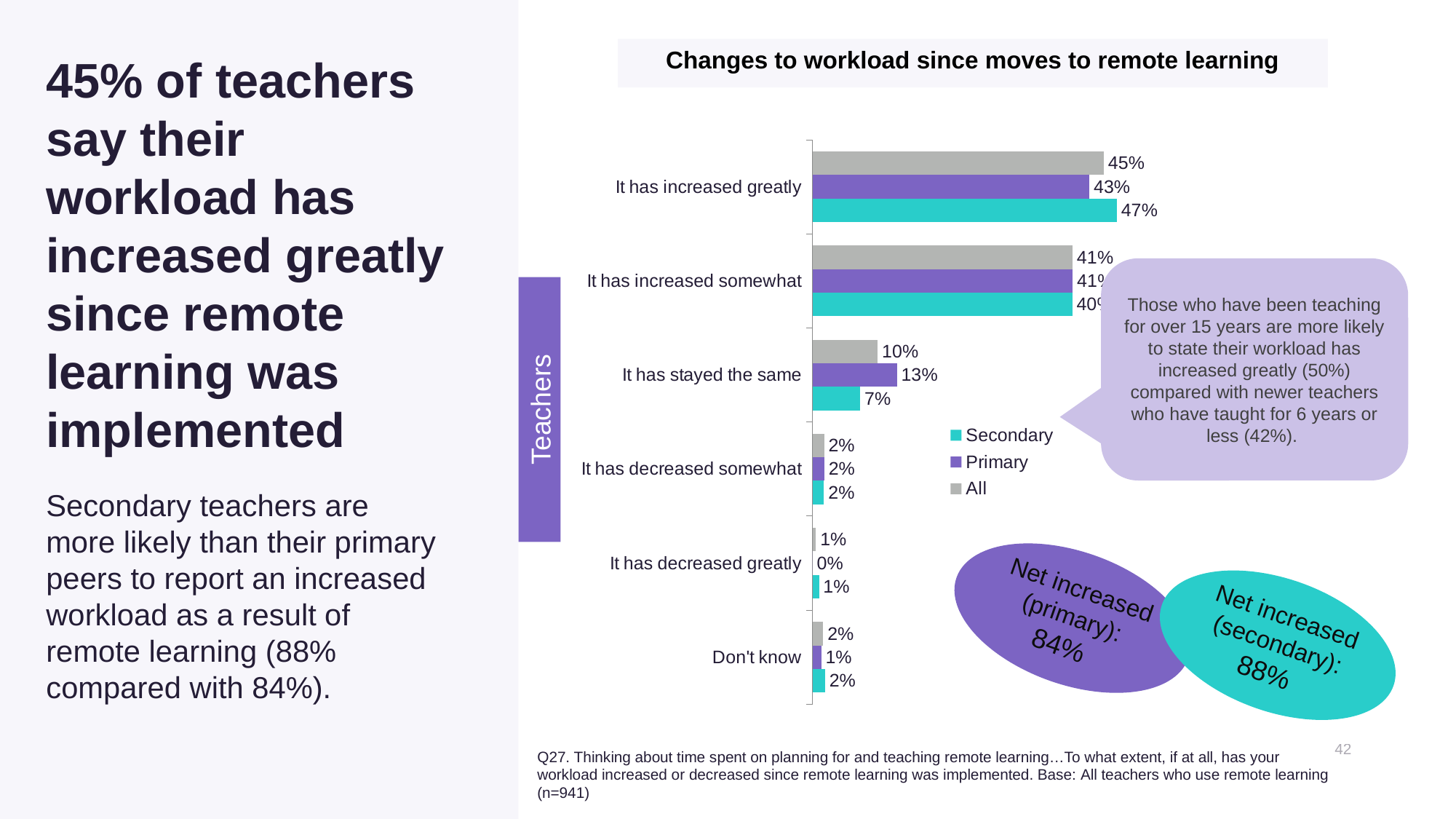
What is the value for Primary in the 'It has decreased greatly' category? 0% Which category has the lowest value for the Primary series? It has decreased greatly Which category has the highest value for the All series? It has increased greatly How many series does the legend list? 3 What is the value for Secondary in the 'It has increased greatly' category? 47% How many response categories are shown on the chart? 6 What kind of chart is shown on the slide? Bar chart Which is larger for 'It has stayed the same': the Primary value or the Secondary value? Primary What is the difference between the Secondary and Primary values for 'It has increased greatly'? 4% What is the title of the chart? Changes to workload since moves to remote learning What is the value for All in the 'It has increased somewhat' category? 41% What is the value for Primary in the 'It has stayed the same' category? 13%